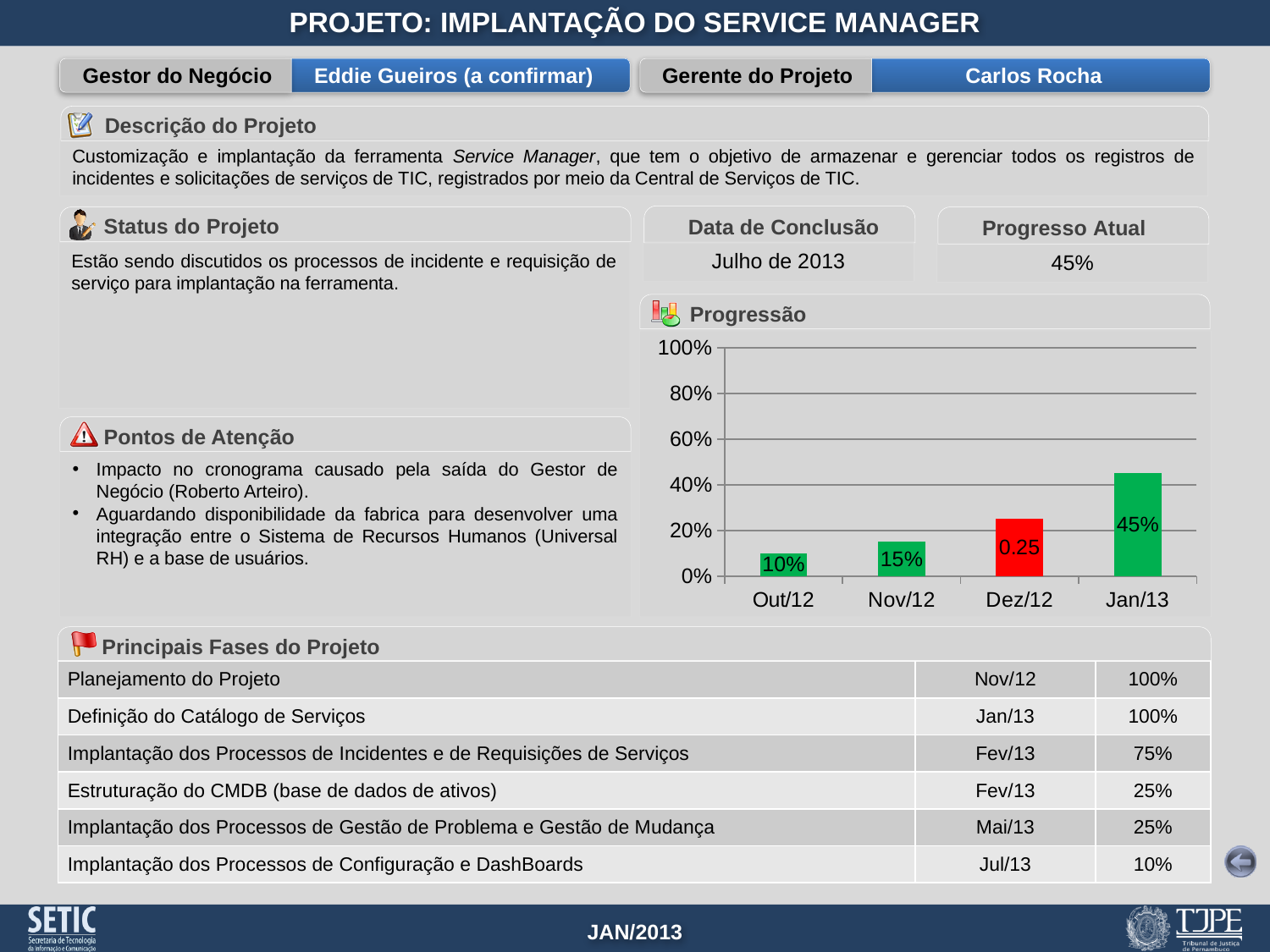
What is the value for Nov/12 in the Progressão chart? 15% Do the values in the Progressão chart rise or fall from Out/12 to Jan/13? rise What is the value for Out/12 in the Progressão chart? 10% What is the difference between the Jan/13 and Out/12 values in the Progressão chart? 35% What data label is shown on the Dez/12 bar in the Progressão chart? 0.25 What is the value for Jan/13 in the Progressão chart? 45% In the Progressão chart, is the value for Jan/13 greater or less than 40%? greater Which month has the lowest value in the Progressão chart? Out/12 What kind of chart is the Progressão chart? bar chart Which month has the highest value in the Progressão chart? Jan/13 How many months are plotted in the Progressão chart? 4 In the Progressão chart, which is larger, the value for Nov/12 or the value for Out/12? Nov/12